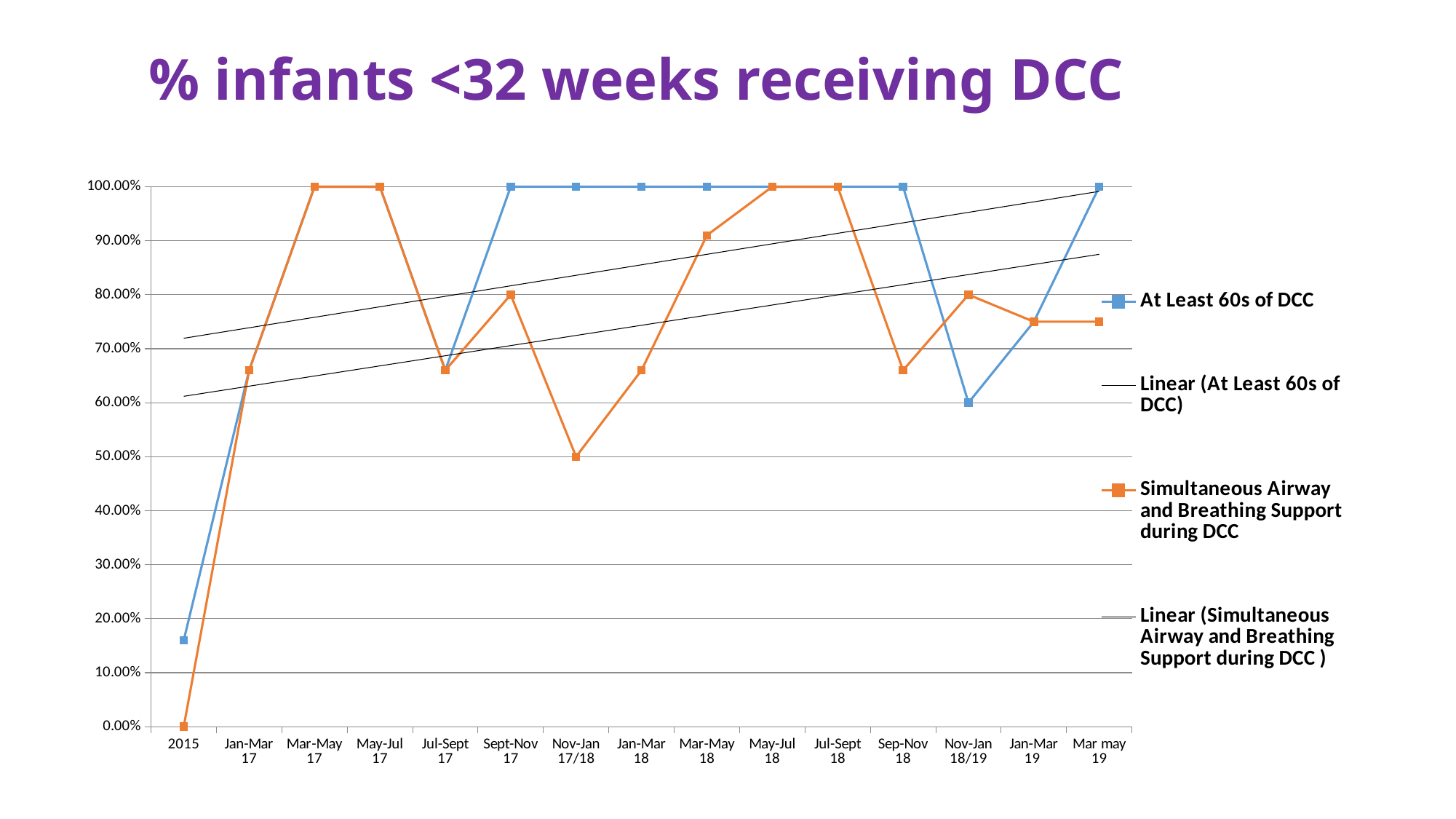
What is the value for Simultaneous Airway and Breathing Support during DCC in 2015? 0.00% What is the value for At Least 60s of DCC in Nov-Jan 18/19? 60.00% In Nov-Jan 17/18, which series has the larger value: At Least 60s of DCC or Simultaneous Airway and Breathing Support during DCC? At Least 60s of DCC Which period has the lowest value for Simultaneous Airway and Breathing Support during DCC? 2015 Is the value for At Least 60s of DCC in 2015 greater or less than 20.00%? less What is the value for Simultaneous Airway and Breathing Support during DCC in Sept-Nov 17? 80.00% How many periods are shown on the x axis? 15 Which period has the lowest value for At Least 60s of DCC? 2015 What is the value for Simultaneous Airway and Breathing Support during DCC in Nov-Jan 17/18? 50.00% What is the value for At Least 60s of DCC in Mar-May 18? 100.00% What kind of chart is shown on the slide? line chart